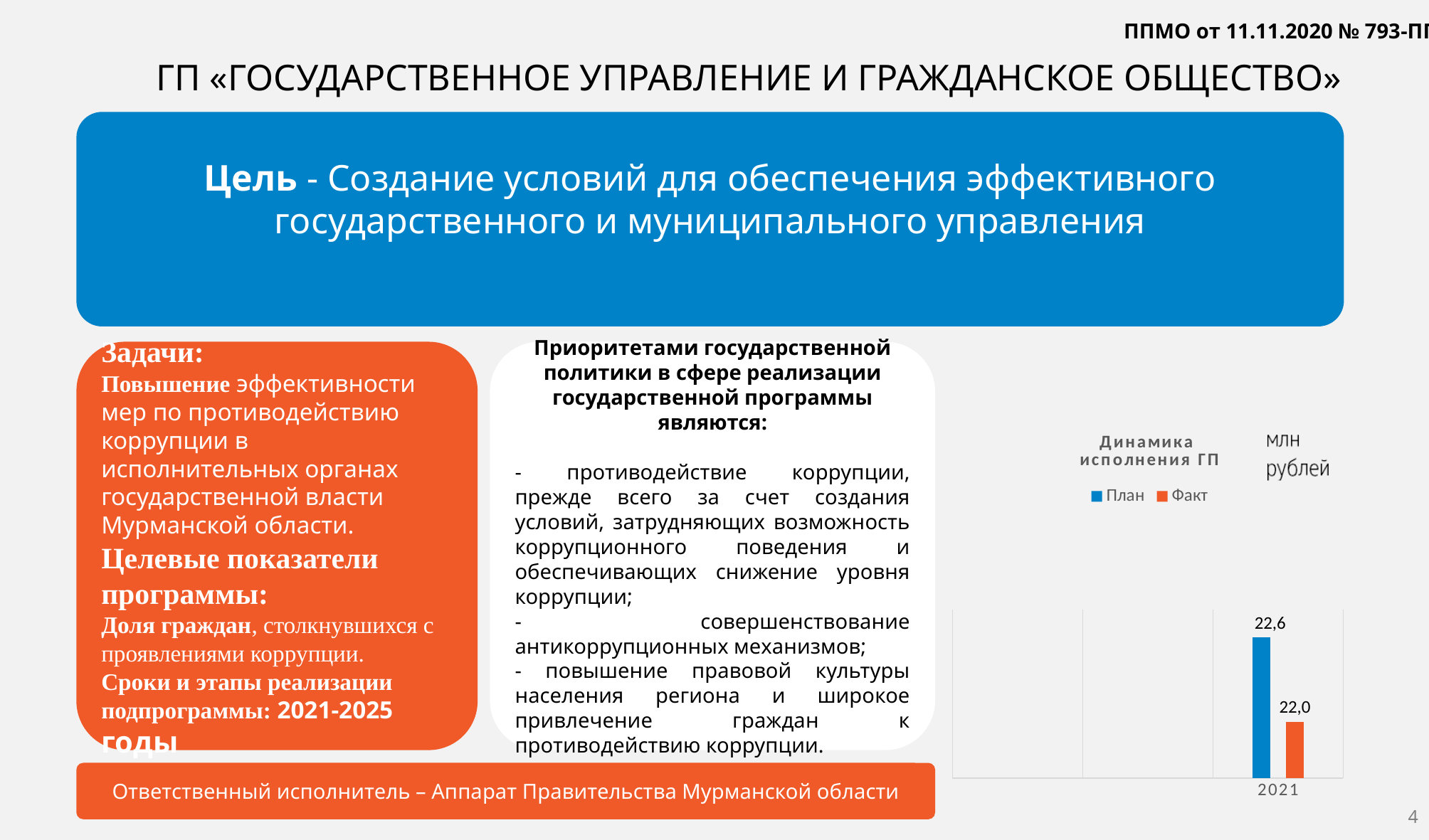
What is the value of План for 2021 in the chart? 22,6 How many series does the chart legend list? 2 What is the difference between План and Факт for 2021? 0,6 What is the title of the chart? Динамика исполнения ГП What unit is indicated next to the chart title? млн рублей Which series has the higher value for 2021, План or Факт? План What is the value of Факт for 2021 in the chart? 22,0 Which year is shown on the x axis of the chart? 2021 How many categories are shown on the x axis of the chart? 1 What kind of chart is shown on the slide? Bar chart